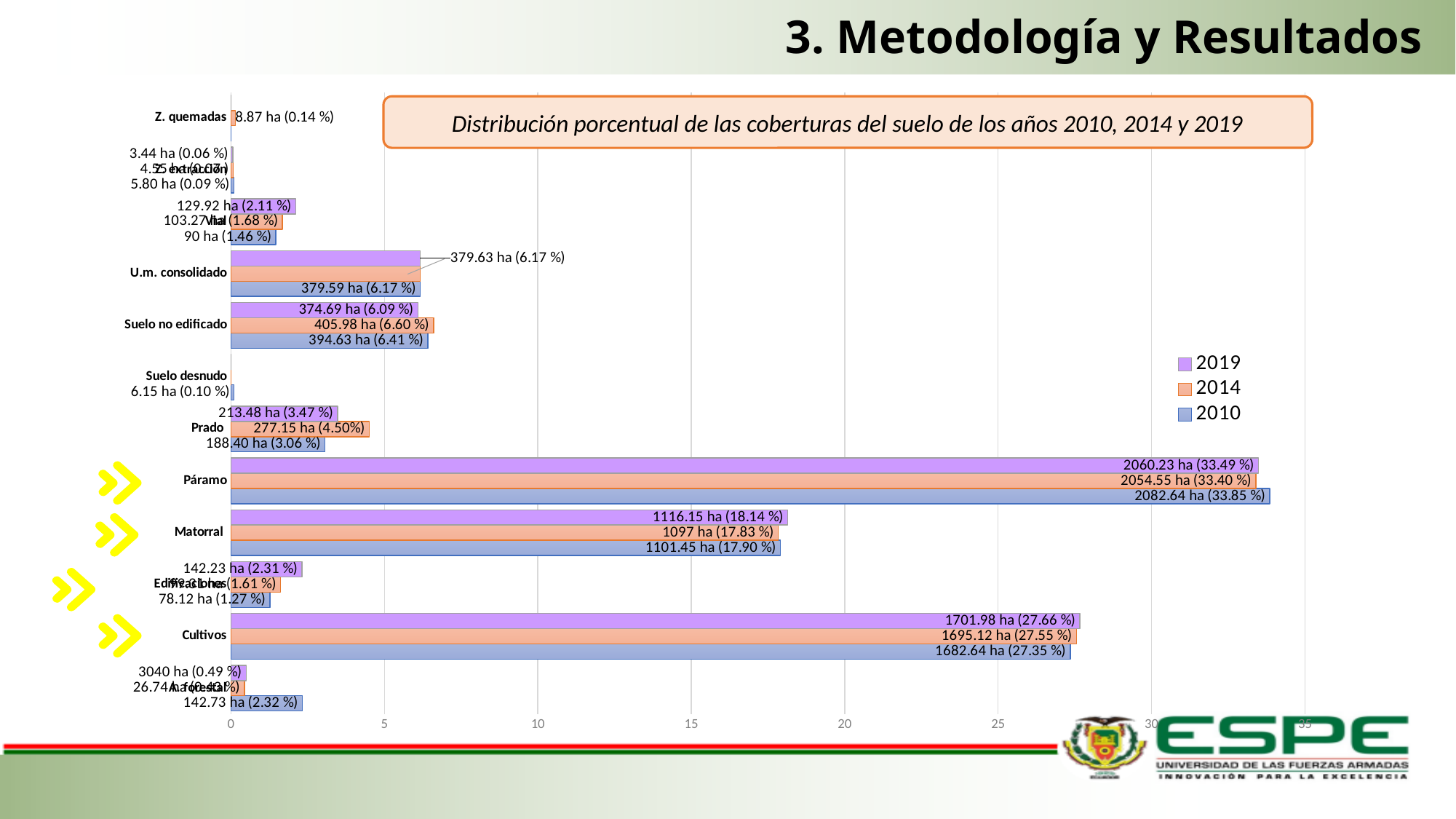
What kind of chart is shown on the slide? bar chart What is the value for Prado in 2014? 277.15 ha (4.50%) What is the value for Cultivos in 2019? 1701.98 ha (27.66 %) What is the value for Páramo in 2010? 2082.64 ha (33.85 %) Is the value for Matorral in 2019 greater or less than 15? greater Is the value for Cultivos in 2010 greater or less than 25? greater How many series does the legend list? 3 For Suelo no edificado, which year has the larger value, 2014 or 2010? 2014 Which years are listed in the legend? 2019, 2014, 2010 What is the difference in hectares between Páramo in 2010 and Páramo in 2019? 22.41 ha Which category has the highest value for 2019? Páramo What is the value for Matorral in 2014? 1097 ha (17.83 %)